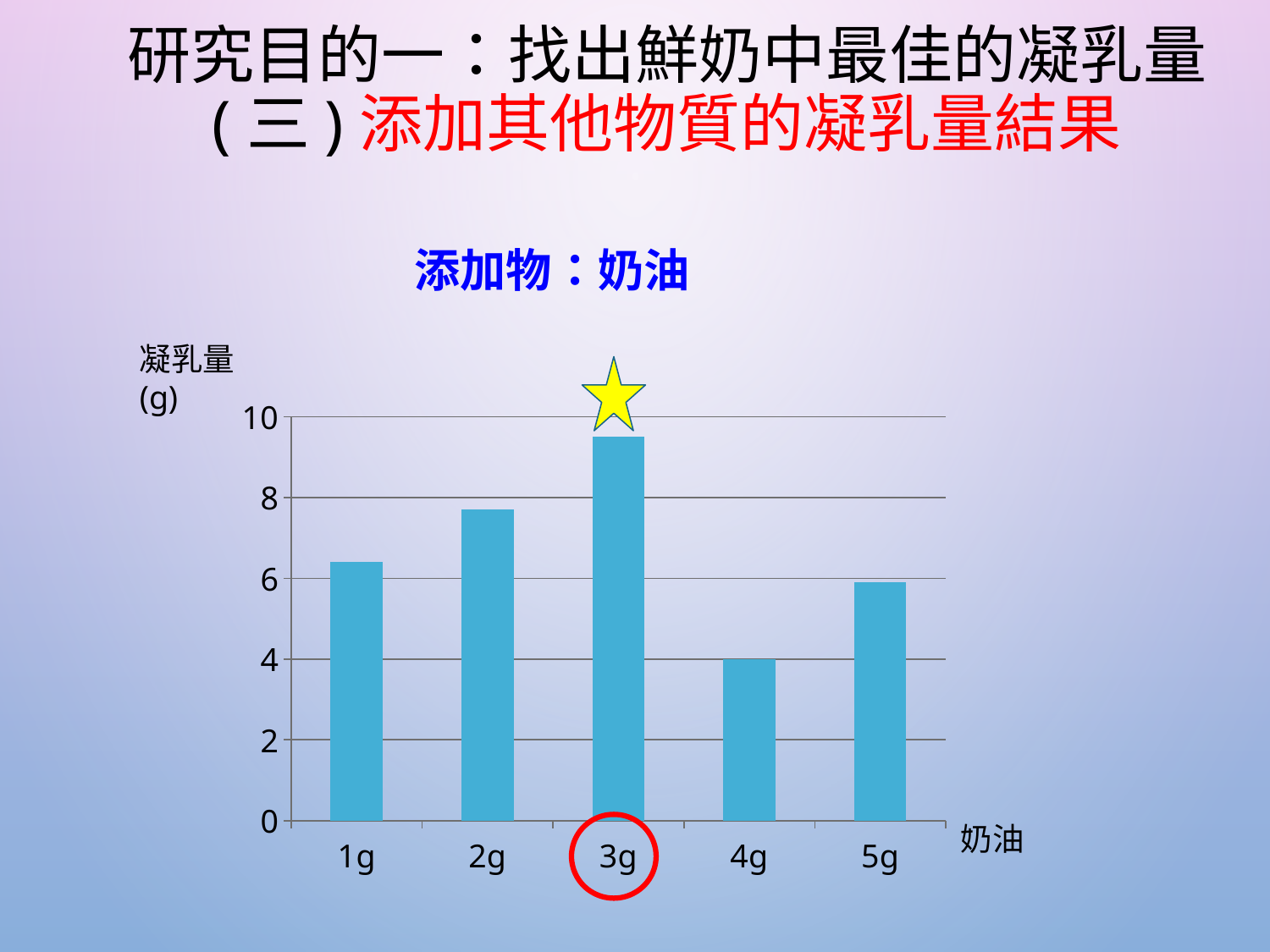
Is the 凝乳量 for 1g of 奶油 greater or less than 6? greater Which amount of 奶油 gives the lowest 凝乳量? 4g Which x-axis category is circled in red and marked with a star? 3g Is the 凝乳量 for 2g of 奶油 greater or less than 8? less Which has a larger 凝乳量, 1g or 4g of 奶油? 1g What kind of chart is shown on the slide? bar chart Is the 凝乳量 for 3g of 奶油 greater or less than 8? greater Which has a larger 凝乳量, 2g or 5g of 奶油? 2g Which amount of 奶油 gives the highest 凝乳量? 3g How many categories (amounts of 奶油) are plotted on the x axis? 5 What is the title shown above the chart? 添加物：奶油